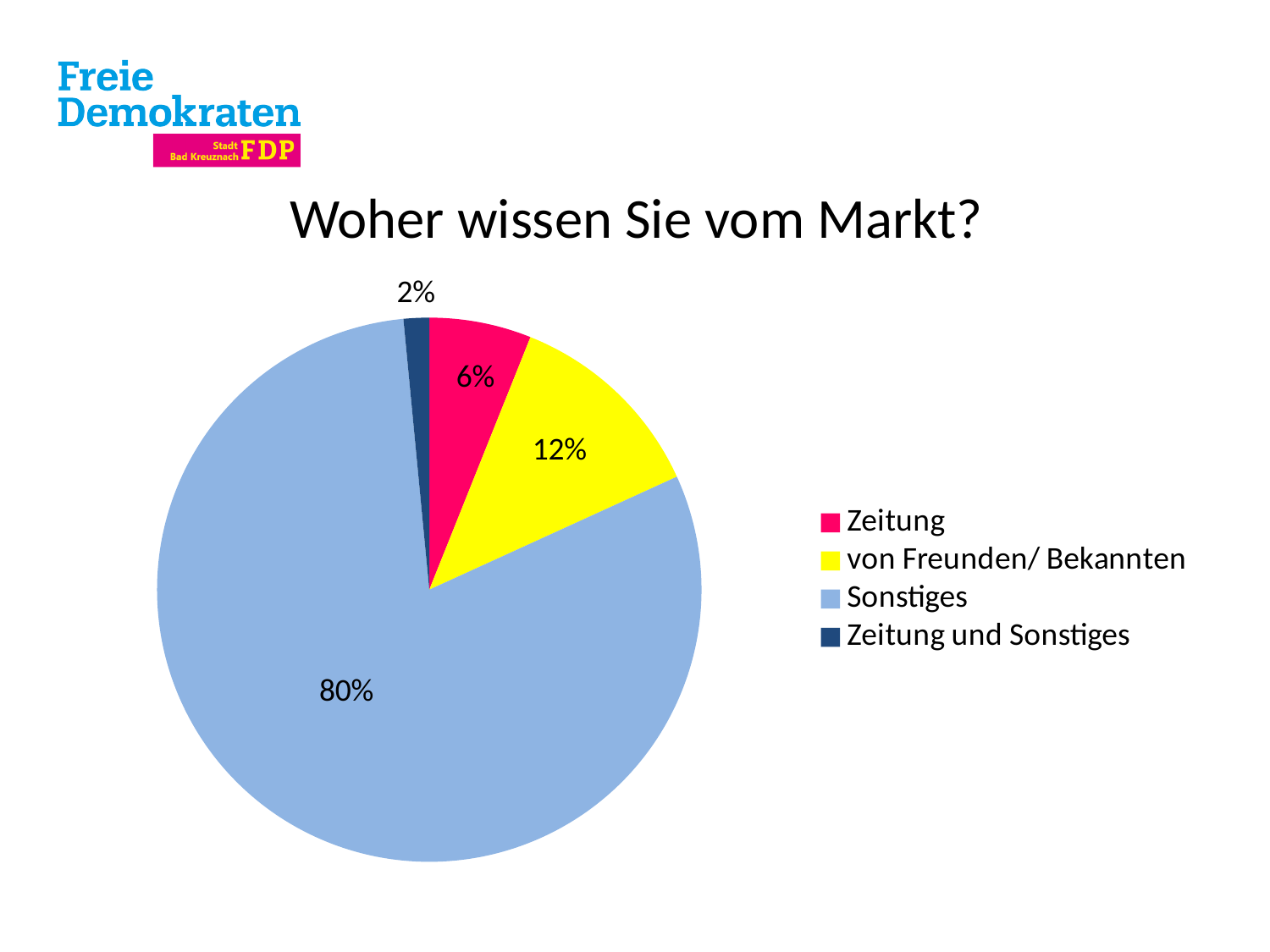
What kind of chart is shown on the slide? pie chart What share of the pie does Sonstiges have? 80% What is the difference in percentage points between Sonstiges and von Freunden/ Bekannten? 68 What is the title of the chart? Woher wissen Sie vom Markt? How many categories does the pie chart show? 4 What share of the pie does von Freunden/ Bekannten have? 12% Which category has the smallest slice of the pie? Zeitung und Sonstiges Which is larger, the slice for Zeitung or the slice for von Freunden/ Bekannten? von Freunden/ Bekannten Which colour represents Zeitung in the legend? pink What share of the pie does Zeitung have? 6% Which category has the largest slice of the pie? Sonstiges